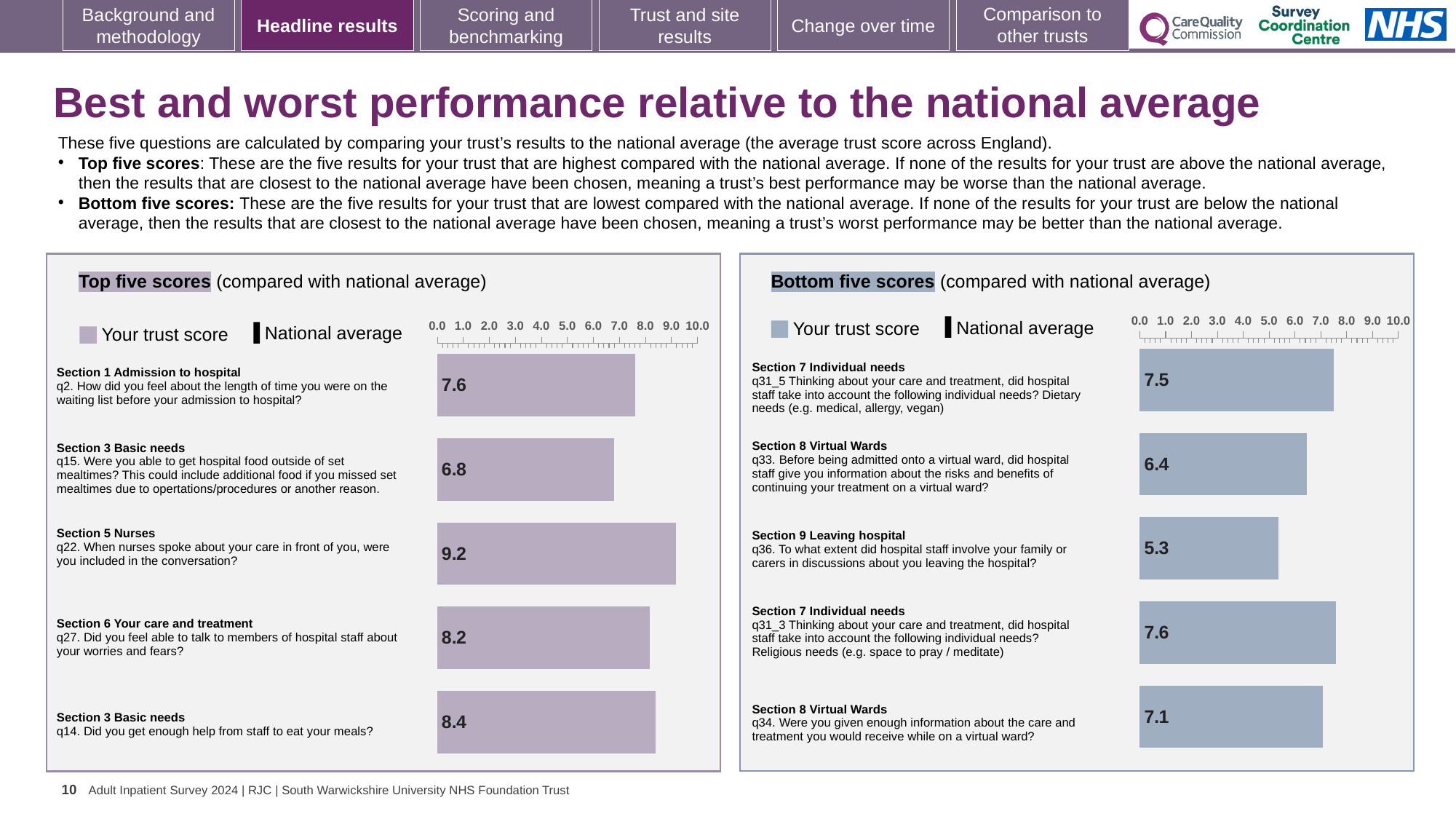
In the Top five scores chart, which question has the highest trust score? q22 In the Bottom five scores chart, which question has the lowest trust score? q36 In the Bottom five scores chart, what is the trust score for q36 (To what extent did hospital staff involve your family or carers in discussions about you leaving the hospital?)? 5.3 In the Bottom five scores chart, what is the difference between the trust scores for q31_3 and q36? 2.3 In the Top five scores chart, what is the trust score for q15 (Were you able to get hospital food outside of set mealtimes?)? 6.8 In the Bottom five scores chart, what is the trust score for q33 (Before being admitted onto a virtual ward, did hospital staff give you information about the risks and benefits?)? 6.4 In the Top five scores chart, what is the trust score for q22 (When nurses spoke about your care in front of you, were you included in the conversation?)? 9.2 How many series does the legend of the Bottom five scores chart list? 2 In the Top five scores chart, what is the difference between the trust scores for q22 and q15? 2.4 What type of chart is used for the Top five scores? Bar chart In the Top five scores chart, which has the larger trust score: q27 or q14? q14 How many bars are shown in the Bottom five scores chart? 5